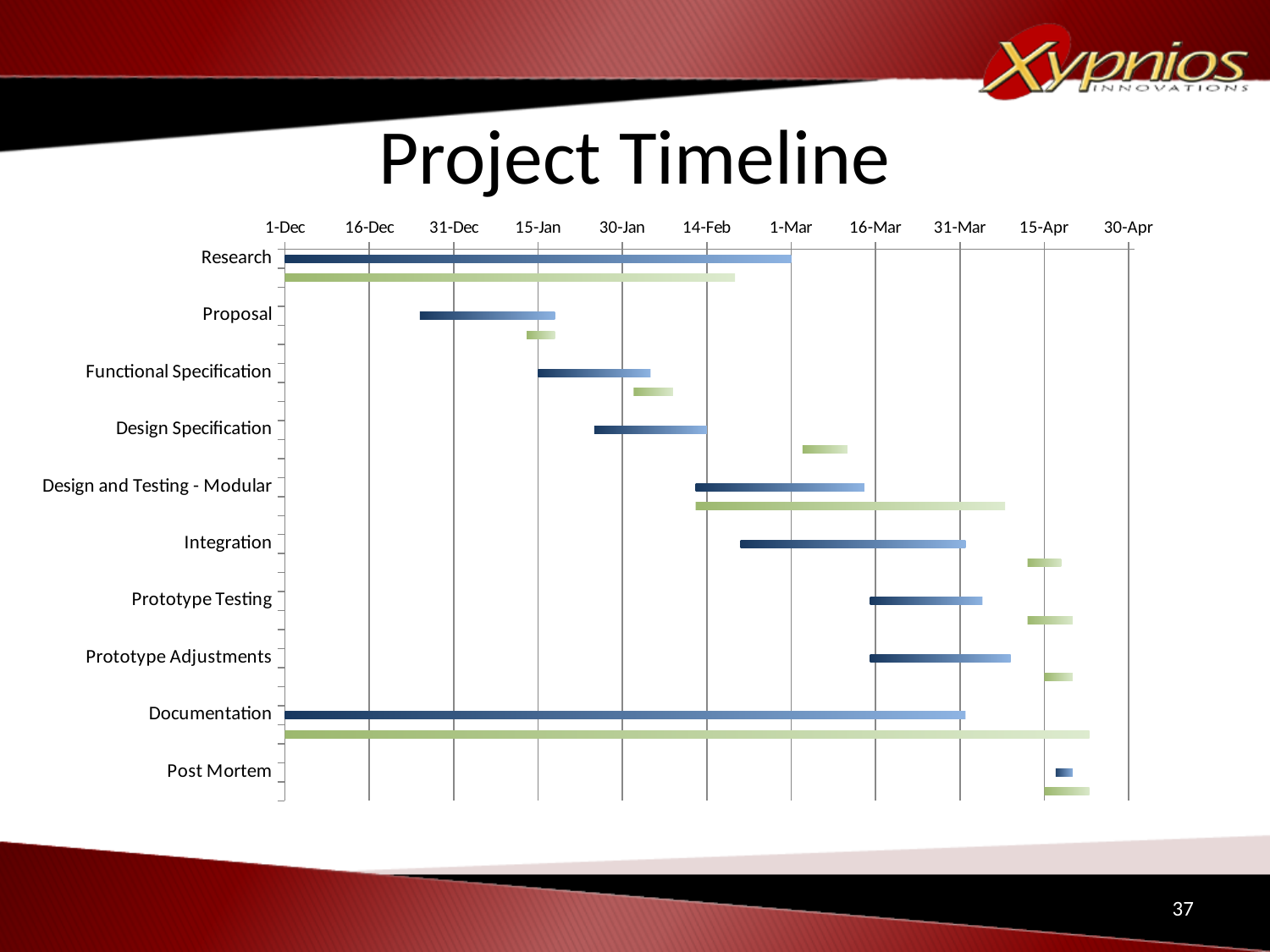
Which task has the longest blue bar in the chart? Documentation Which task's bars start latest on the timeline? Post Mortem Does the blue bar for Proposal start before or after 31-Dec? before What kind of chart is shown on the slide? Bar chart (Gantt chart) Does the green bar for Design and Testing - Modular end before or after 31-Mar? after How many tasks are listed on the vertical axis of the chart? 10 Is the blue bar for Integration longer or shorter than the blue bar for Prototype Testing? longer How many bars are drawn for each task in the chart? 2 Does the green bar for Research end before or after 1-Mar? before What is the first date shown on the horizontal axis? 1-Dec What is the title of the chart? Project Timeline Which task has the shortest blue bar in the chart? Post Mortem